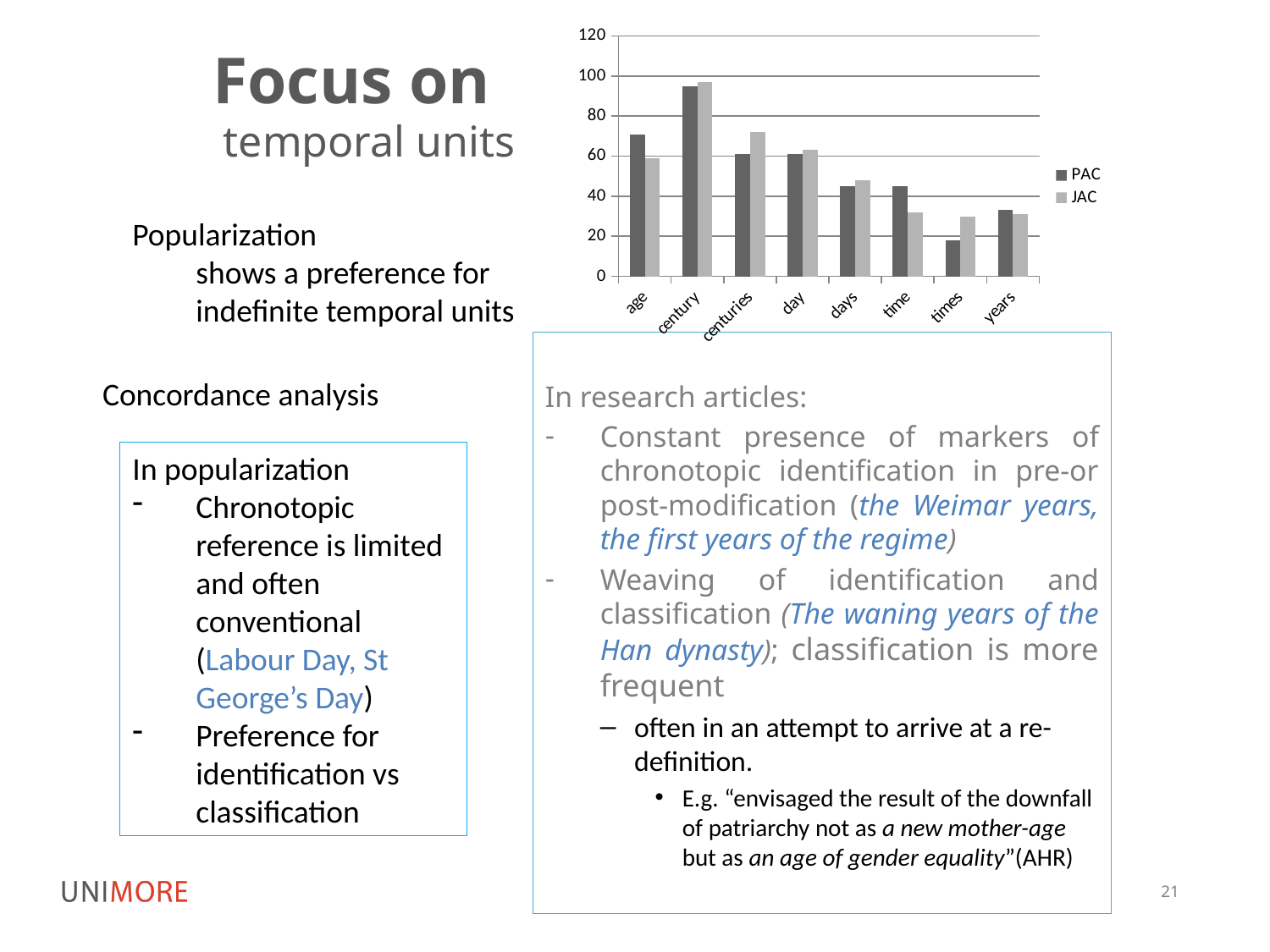
What kind of chart is shown on the slide? bar chart For the category times, which series has the larger value, PAC or JAC? JAC Which category has the lowest PAC value? times Is the JAC value for centuries greater or less than 60? greater Is the PAC value for century greater or less than 80? greater Which category has the highest PAC value? century For the category age, which series has the larger value, PAC or JAC? PAC Is the PAC value for times greater or less than 20? less How many categories are shown on the x axis of the chart? 8 What are the two series named in the chart's legend? PAC and JAC How many series does the chart's legend list? 2